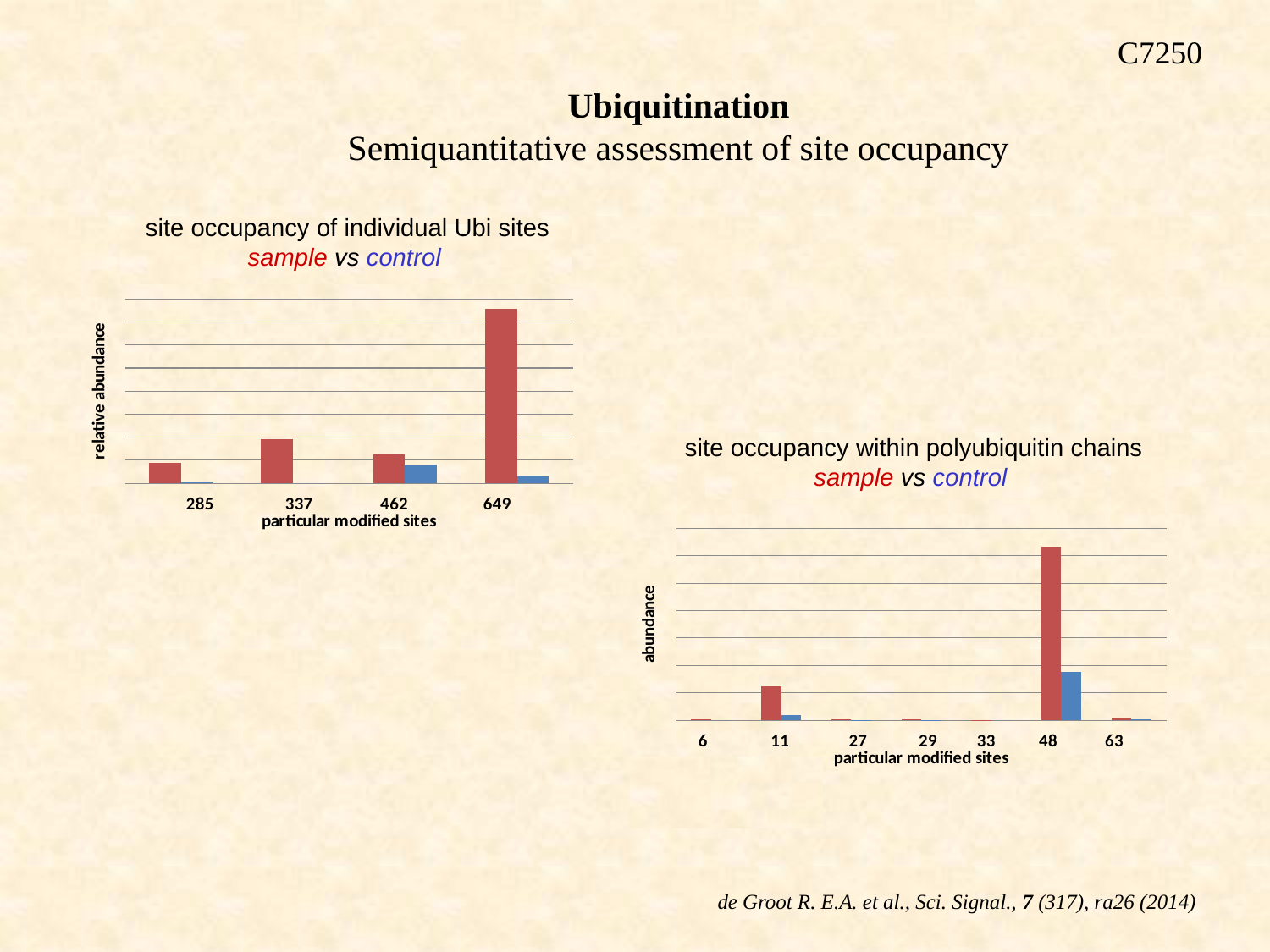
In the chart titled 'site occupancy of individual Ubi sites', which modified site has the lowest sample (red) bar? 285 In the chart titled 'site occupancy of individual Ubi sites', is the sample (red) bar taller at site 337 or at site 462? 337 In the chart titled 'site occupancy of individual Ubi sites', which modified site has the highest control (blue) bar? 462 In the chart titled 'site occupancy within polyubiquitin chains', at site 11, is the sample (red) bar or the control (blue) bar taller? sample (red) What is the y-axis label of the chart titled 'site occupancy within polyubiquitin chains'? abundance In the chart titled 'site occupancy within polyubiquitin chains', which modified site has the highest control (blue) bar? 48 In the chart titled 'site occupancy within polyubiquitin chains', how many modified sites are shown on the x axis? 7 In the chart titled 'site occupancy of individual Ubi sites', how many modified sites are shown on the x axis? 4 In the chart titled 'site occupancy within polyubiquitin chains', which modified site has the highest sample (red) bar? 48 In the chart titled 'site occupancy within polyubiquitin chains', how many data series (sample vs control) are plotted? 2 What kind of chart is the chart titled 'site occupancy of individual Ubi sites'? bar chart